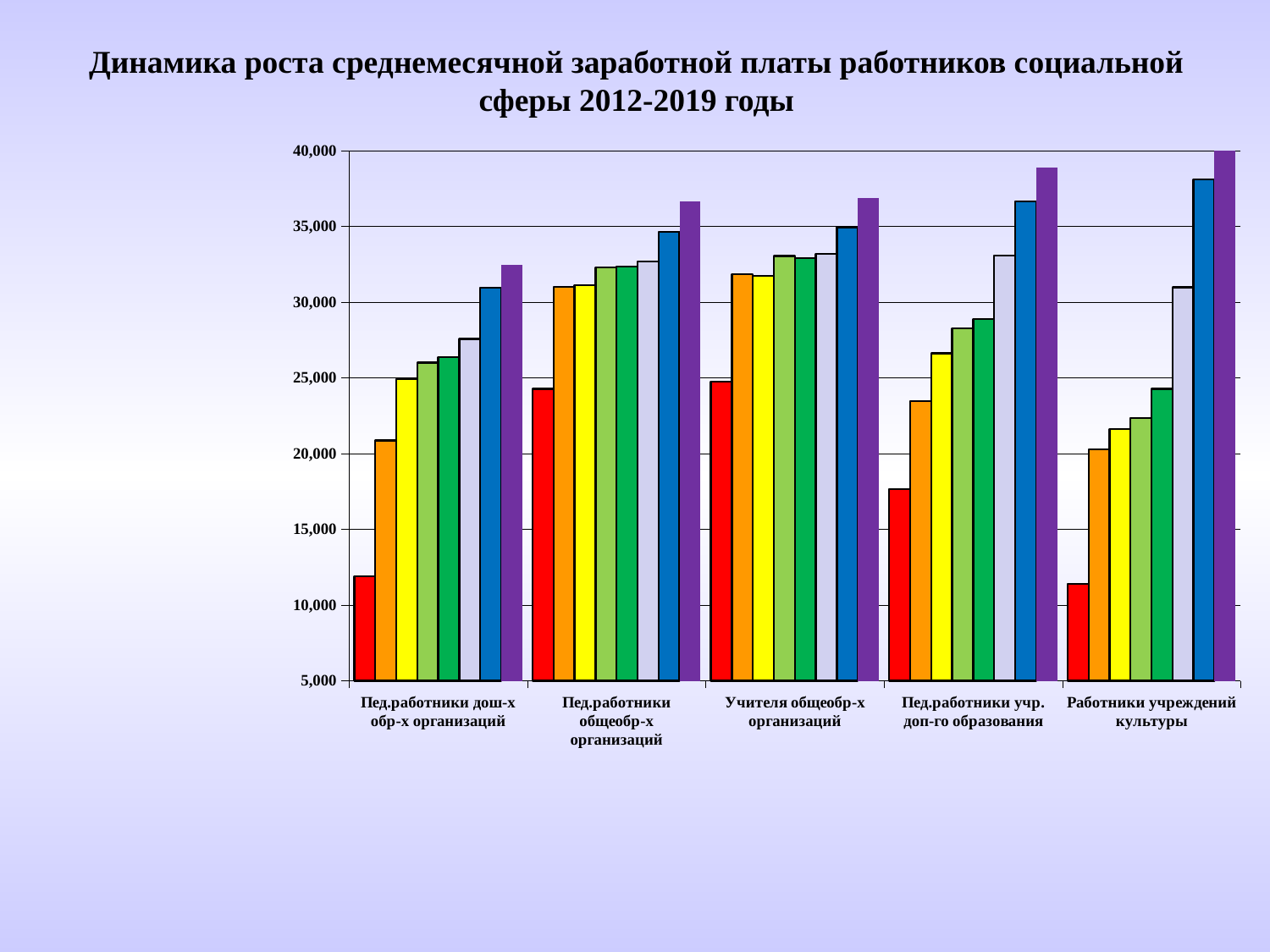
Which is larger: the first (red) bar for Учителя общеобр-х организаций or the first (red) bar for Пед.работники учр. доп-го образования? Учителя общеобр-х организаций Which category contains the tallest bar in the chart? Работники учреждений культуры Is the value of the last (purple) bar for Пед.работники дош-х обр-х организаций greater or less than 30,000? greater How many bars are plotted for each category in the chart? 8 Is the value of the first (red) bar for Пед.работники дош-х обр-х организаций greater or less than 10,000? greater What kind of chart is shown on the slide? bar chart Is the value of the blue bar for Работники учреждений культуры greater or less than 35,000? greater How many categories are shown along the x axis of the chart? 5 What is the title of the chart on the slide? Динамика роста среднемесячной заработной платы работников социальной сферы 2012-2019 годы Within the category Работники учреждений культуры, do the bars rise or fall from left to right? rise What is the highest value shown on the y axis of the chart? 40,000